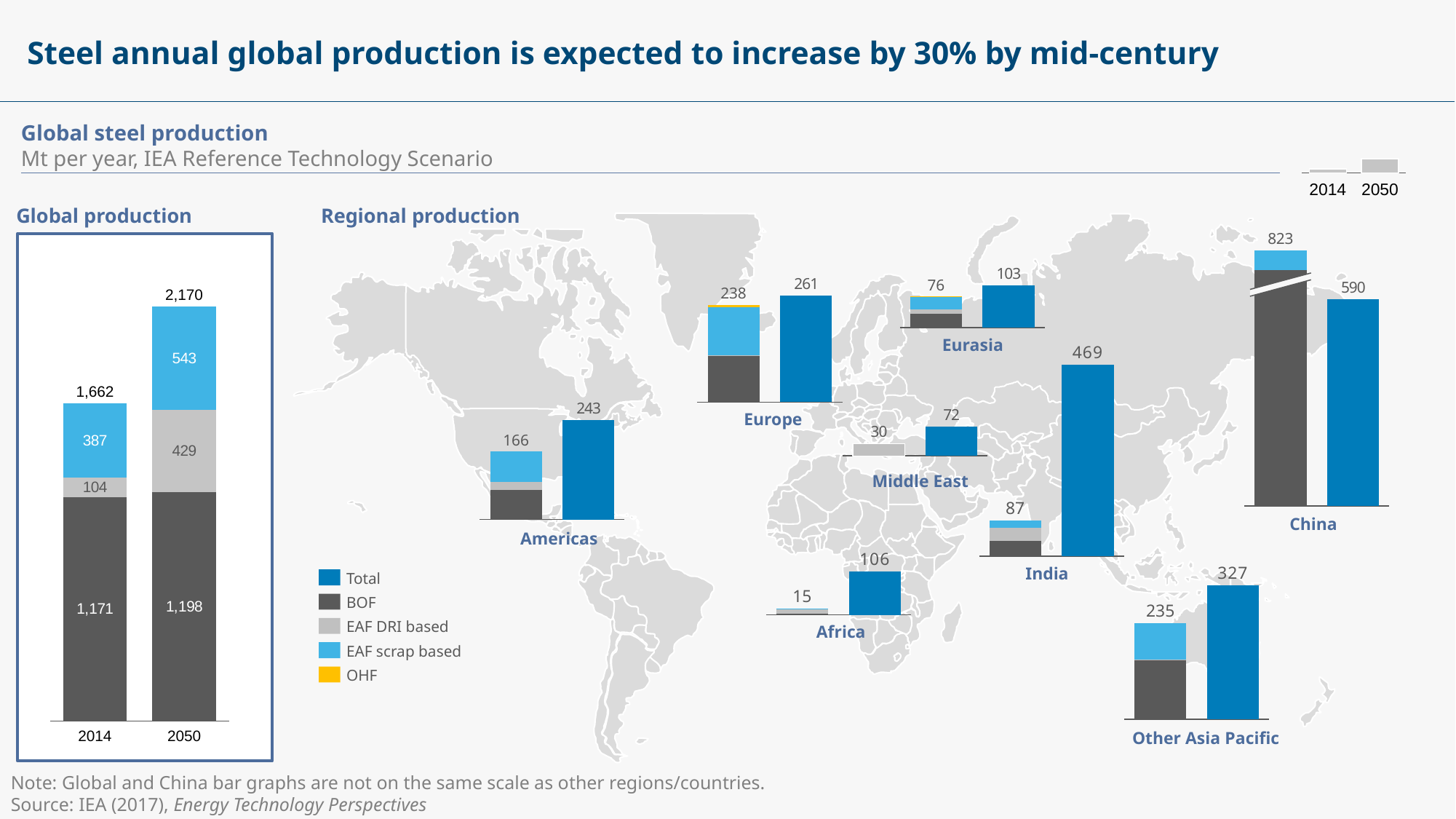
In the Regional production chart, what is the difference between Africa's 2050 and 2014 totals? 91 In the Global production chart, what is the total global steel production for 2014? 1,662 In the Regional production chart, what is the 2050 total for India? 469 In the Global production chart, what is the EAF DRI based value for 2050? 429 In the Regional production chart, does China's production rise or fall from 2014 to 2050? fall In the Regional production chart, which region has the highest 2050 total? China How many entries does the legend list? 5 In the Global production chart, what is the BOF value for 2050? 1,198 In the Regional production chart, which region has the lowest 2014 total? Africa In the Regional production chart, what is the 2014 total for China? 823 In the Regional production chart, which is larger in 2050: Europe or Americas? Europe In the Global production chart, by how much does the EAF scrap based value increase from 2014 to 2050? 156